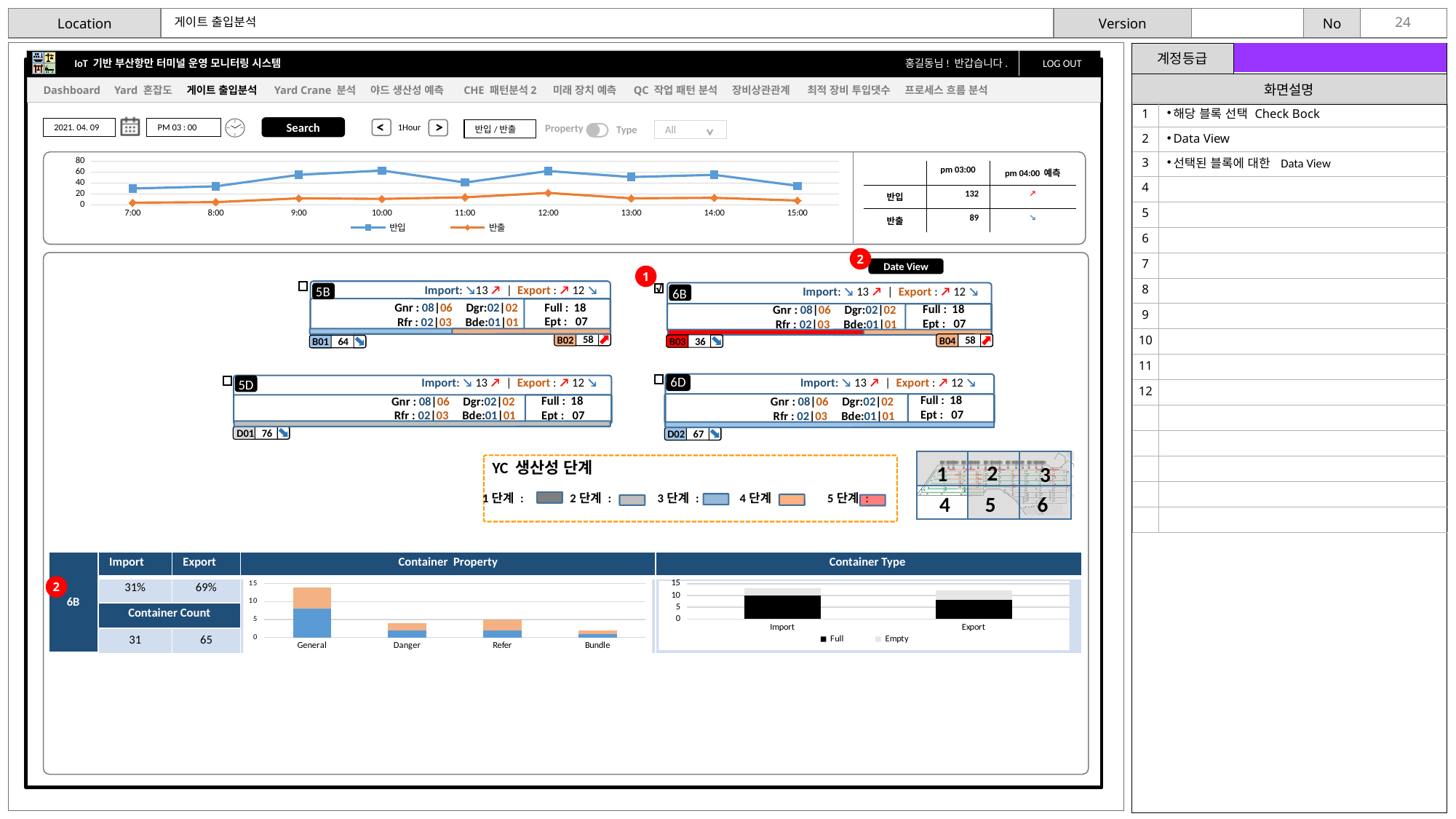
What are the two legend entries of the Container Type chart? Full, Empty How many time points are plotted along the x axis of the top line chart? 9 What kind of chart is the top chart showing 반입 and 반출 over time? line chart In the top line chart, is the 반입 value at 10:00 greater or less than 40? greater What kind of chart is the Container Property chart? bar chart In the top line chart, is the 반출 value at 7:00 greater or less than 20? less In the top line chart, which series is higher at 12:00, 반입 or 반출? 반입 How many series does the legend of the top line chart list? 2 In the Container Property chart, which category has the shortest bar? Bundle In the Container Property chart, which category has the tallest bar? General How many categories are shown on the x axis of the Container Property chart? 4 In the Container Property chart, is the total bar height for General greater or less than 10? greater